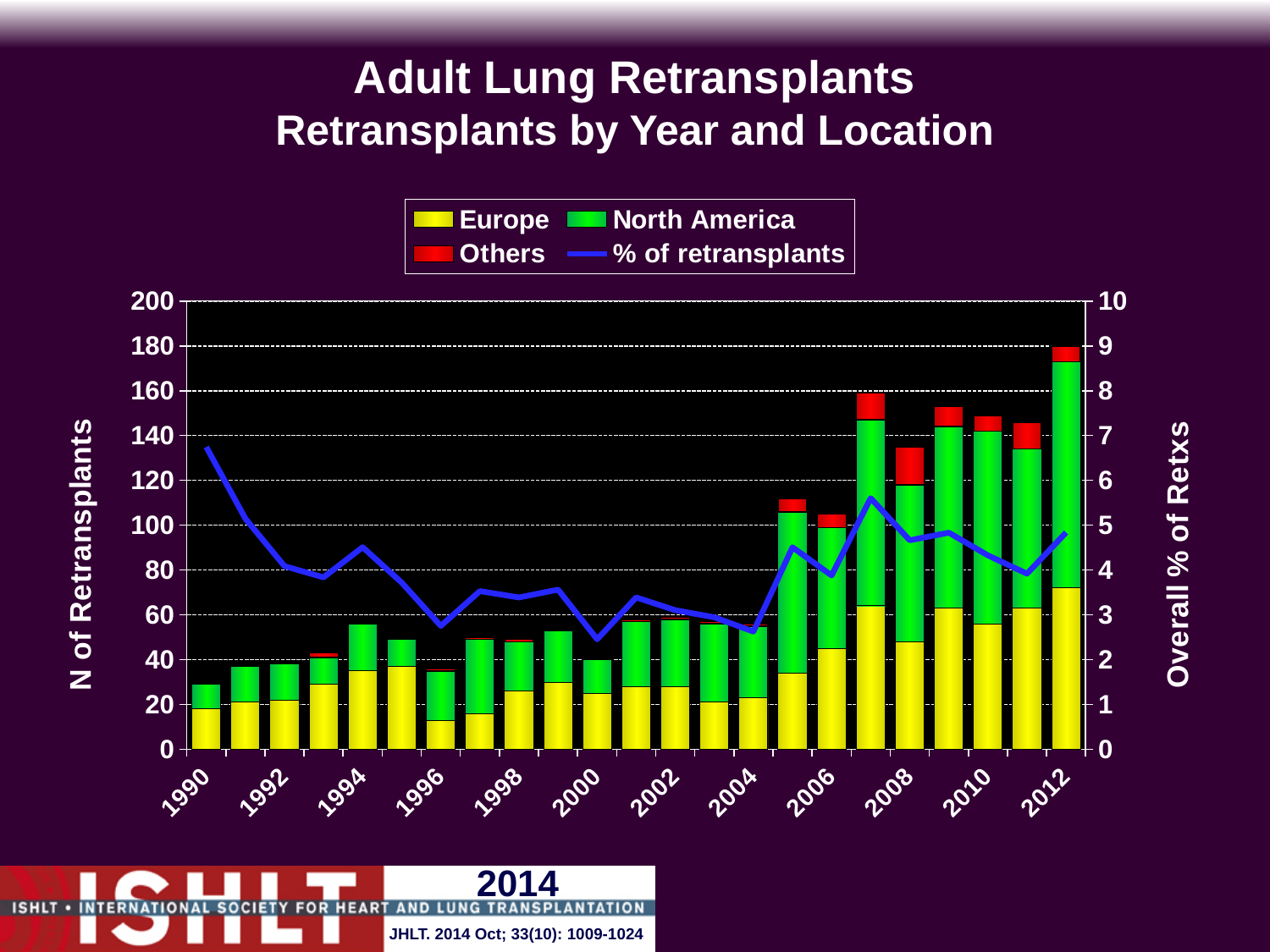
Does the % of retransplants line rise or fall from 1990 to 1993? fall Is the total number of retransplants in 2012 greater or less than 160? greater How many years (bars) are plotted on the x axis? 23 What kind of chart is shown on the slide? combination bar and line chart Is the total number of retransplants in 2005 greater or less than 100? greater Which year has the larger total number of retransplants, 2007 or 2008? 2007 Is the % of retransplants in 2000 greater or less than 3? less Which year has the highest total number of retransplants? 2012 How many series does the legend list? 4 What is the title of the right-hand vertical axis? Overall % of Retxs